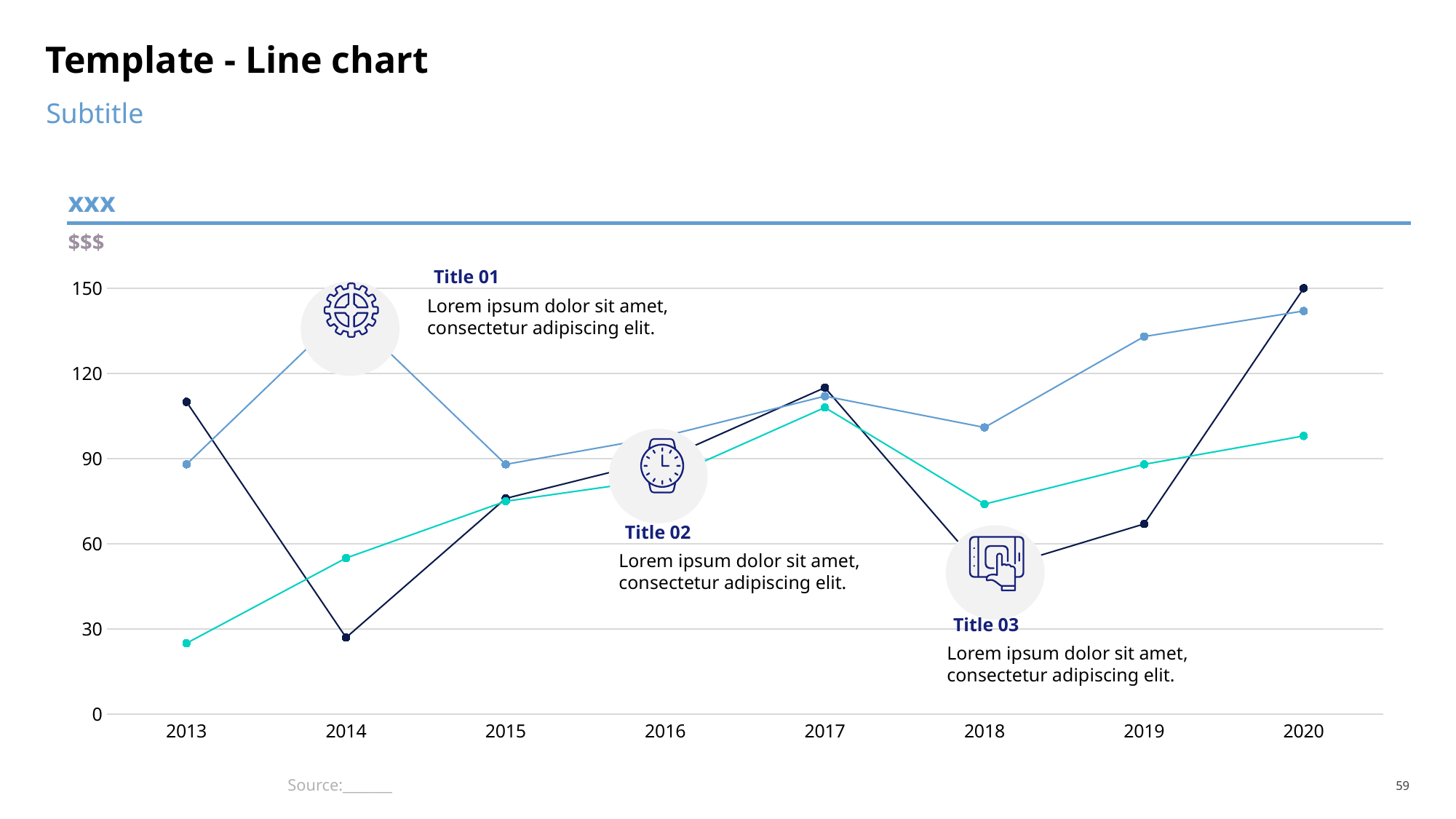
Is the value of the dark navy line in 2013 greater or less than 90? greater In which year does the teal line reach its lowest value? 2013 What kind of chart is shown on the slide? line chart In which year does the teal line reach its highest value? 2017 In which year does the dark navy line reach its lowest value? 2014 Is the value of the light blue line in 2019 greater or less than 120? greater In 2013, which line has the higher value: the dark navy line or the light blue line? dark navy line Is the value of the teal line in 2017 greater or less than 90? greater Does the teal line rise or fall from 2013 to 2015? rise How many years are shown along the x axis of the chart? 8